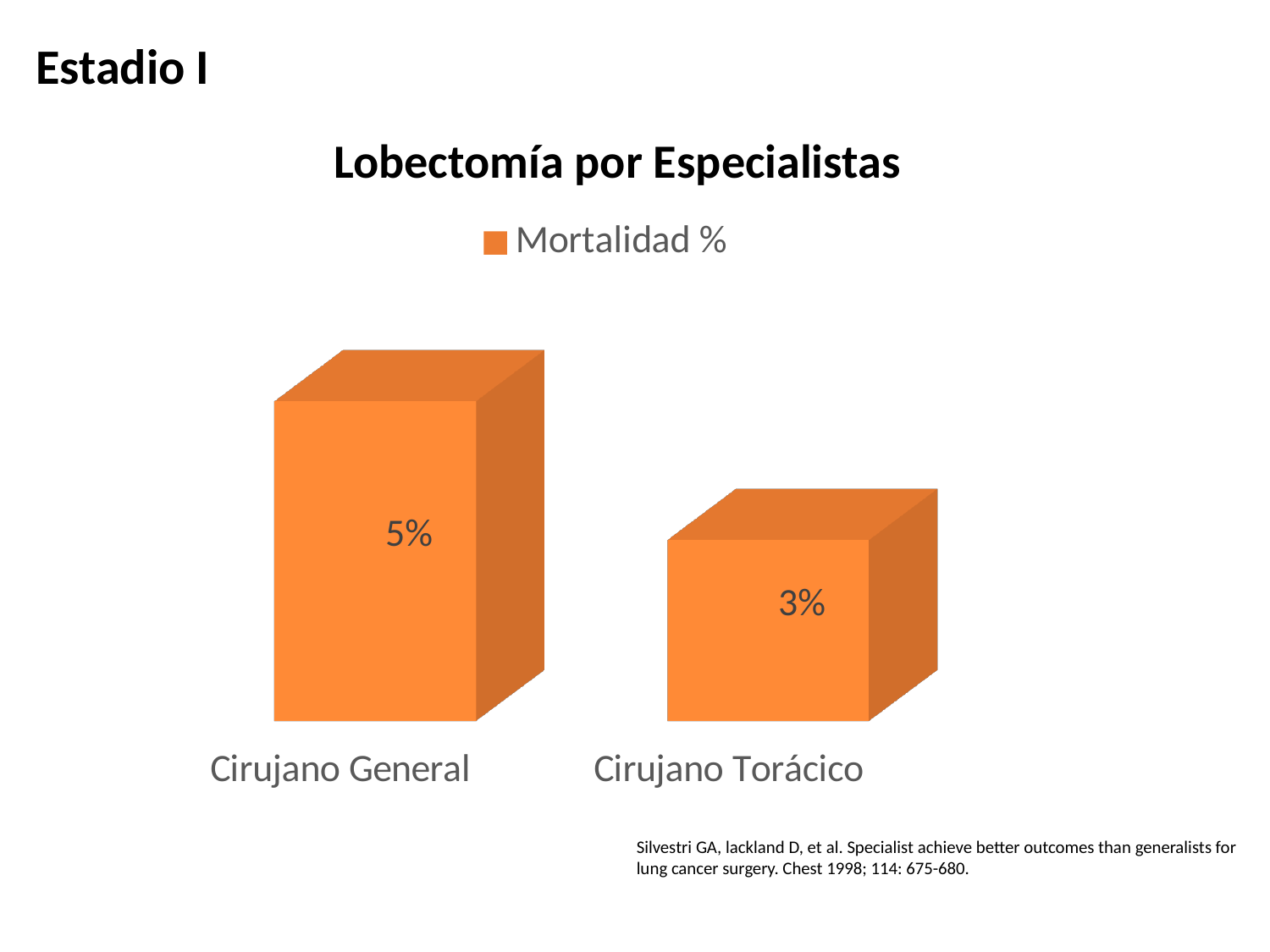
What is the title of the chart? Lobectomía por Especialistas Which category has the lowest Mortalidad %? Cirujano Torácico What is the difference in Mortalidad % between Cirujano General and Cirujano Torácico? 2% What series name is shown in the chart legend? Mortalidad % What kind of chart is shown on the slide? Bar chart What is the Mortalidad % value for Cirujano Torácico? 3% How many categories are shown in the chart? 2 Which category has the highest Mortalidad %? Cirujano General How many series does the legend list? 1 What is the Mortalidad % value for Cirujano General? 5% Which has a higher Mortalidad %, Cirujano General or Cirujano Torácico? Cirujano General